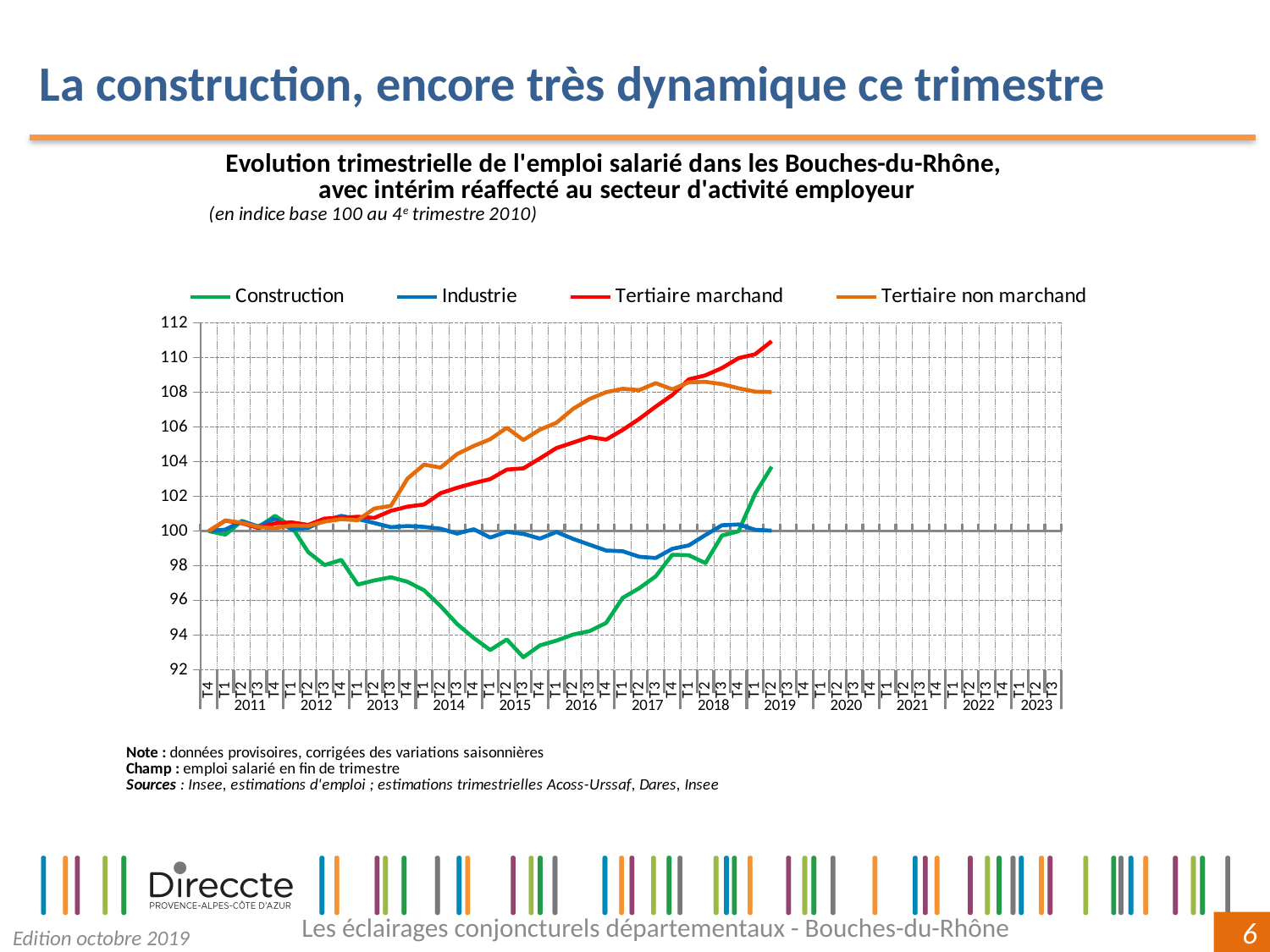
Which series has the lowest value at T1 2015? Construction At T2 2019, which is higher: Construction or Industrie? Construction Which series has the lowest value at T2 2019? Industrie What kind of chart is shown on the slide? Line chart Is the value for Tertiaire marchand at T2 2019 greater or less than 110? greater Is the value for Construction at T3 2015 greater or less than 94? less Which series has the highest value at T2 2019? Tertiaire marchand Does the Tertiaire marchand series rise or fall overall from 2011 to 2019? rise Is the value for Tertiaire non marchand at T2 2019 greater or less than 106? greater How many series does the legend list? 4 What colour is the Construction line in the legend? Green